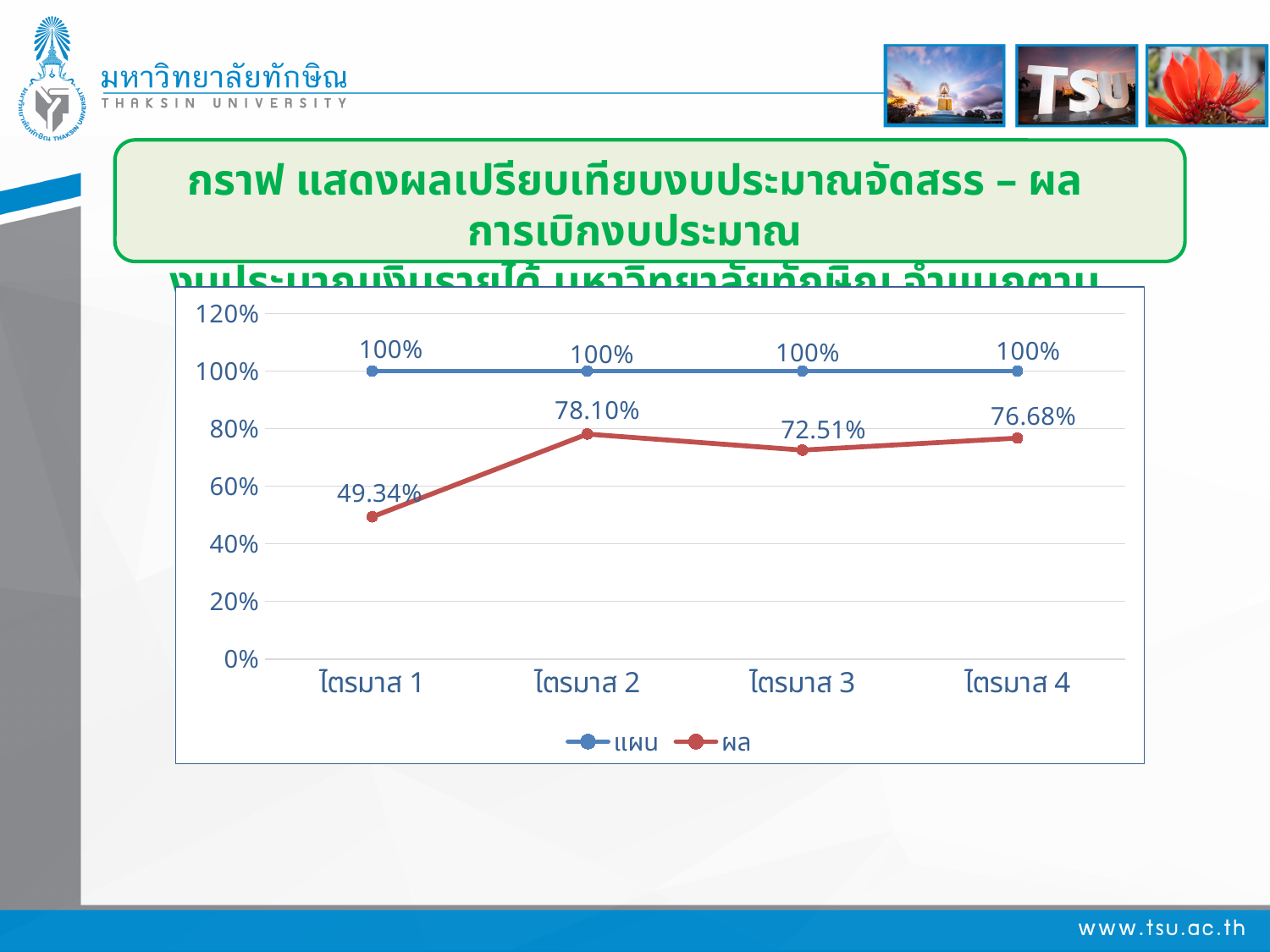
What is the difference between the แผน and ผล values for ไตรมาส 4? 23.32% In which quarter is the ผล series lowest? ไตรมาส 1 In which quarter is the ผล series highest? ไตรมาส 2 What is the value of the ผล series for ไตรมาส 3? 72.51% What is the value of the ผล series for ไตรมาส 1? 49.34% What is the value of the ผล series for ไตรมาส 2? 78.10% How many quarters are shown on the x axis? 4 What is the value of the แผน series for ไตรมาส 4? 100% How many series does the legend list? 2 Does the ผล series rise or fall from ไตรมาส 1 to ไตรมาส 2? Rise Which is larger, the ผล value for ไตรมาส 2 or for ไตรมาส 3? ไตรมาส 2 What kind of chart is shown on the slide? Line chart